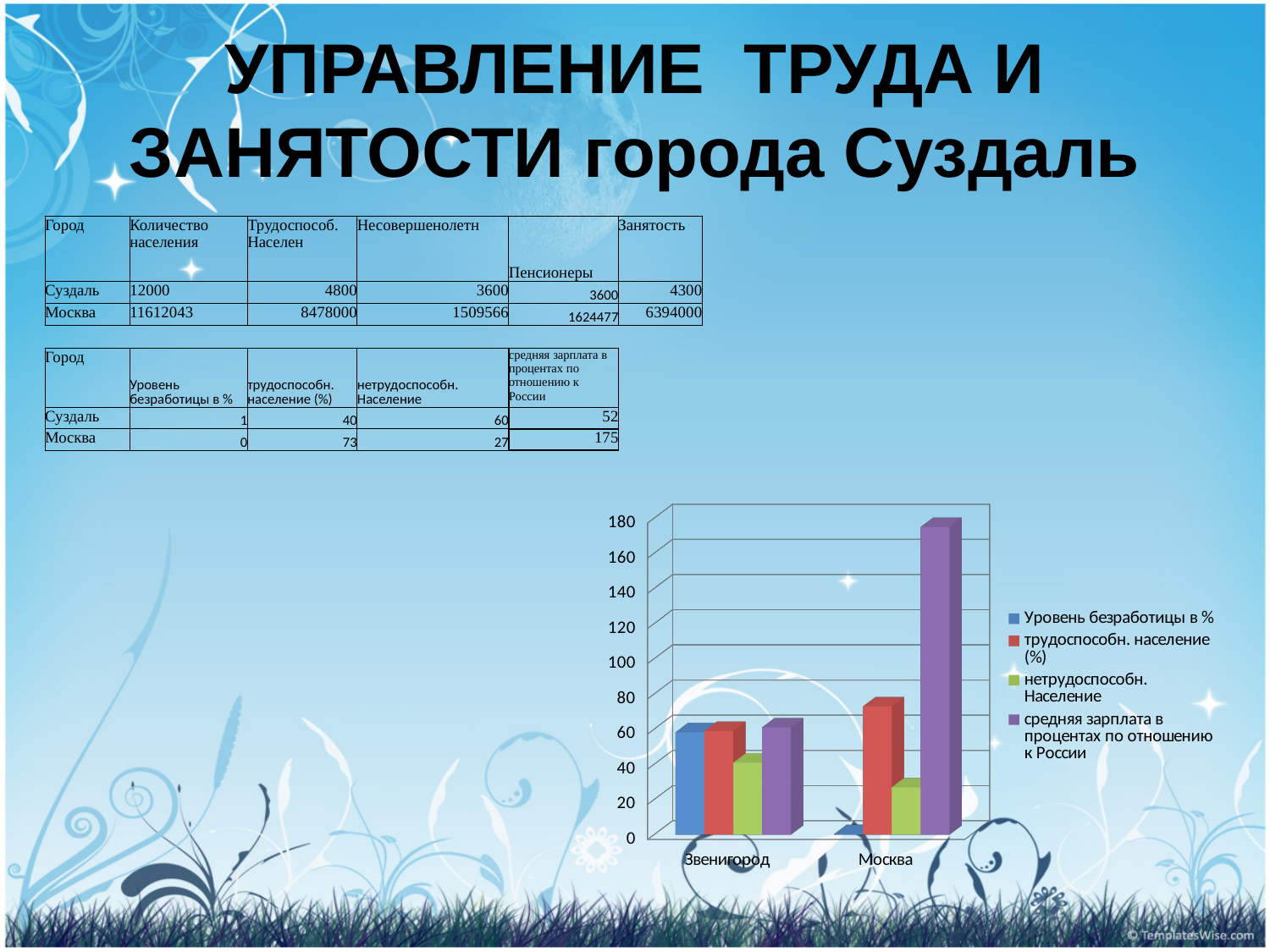
What kind of chart is shown on the slide? bar chart Which series has the lowest value for Москва? Уровень безработицы в % How many categories are shown on the x axis of the chart? 2 What colour represents the series средняя зарплата в процентах по отношению к России in the chart? purple Is the value of нетрудоспособн. Население for Звенигород greater or less than 60? less Which city has the larger value for нетрудоспособн. Население, Звенигород or Москва? Звенигород Which series has the highest value for Москва? средняя зарплата в процентах по отношению к России Which series has the lowest value for Звенигород? нетрудоспособн. Население How many series does the chart legend list? 4 Is the value of трудоспособн. население (%) for Москва greater or less than 60? greater Which city has the larger value for средняя зарплата в процентах по отношению к России, Звенигород or Москва? Москва Is the value of средняя зарплата в процентах по отношению к России for Москва greater or less than 160? greater